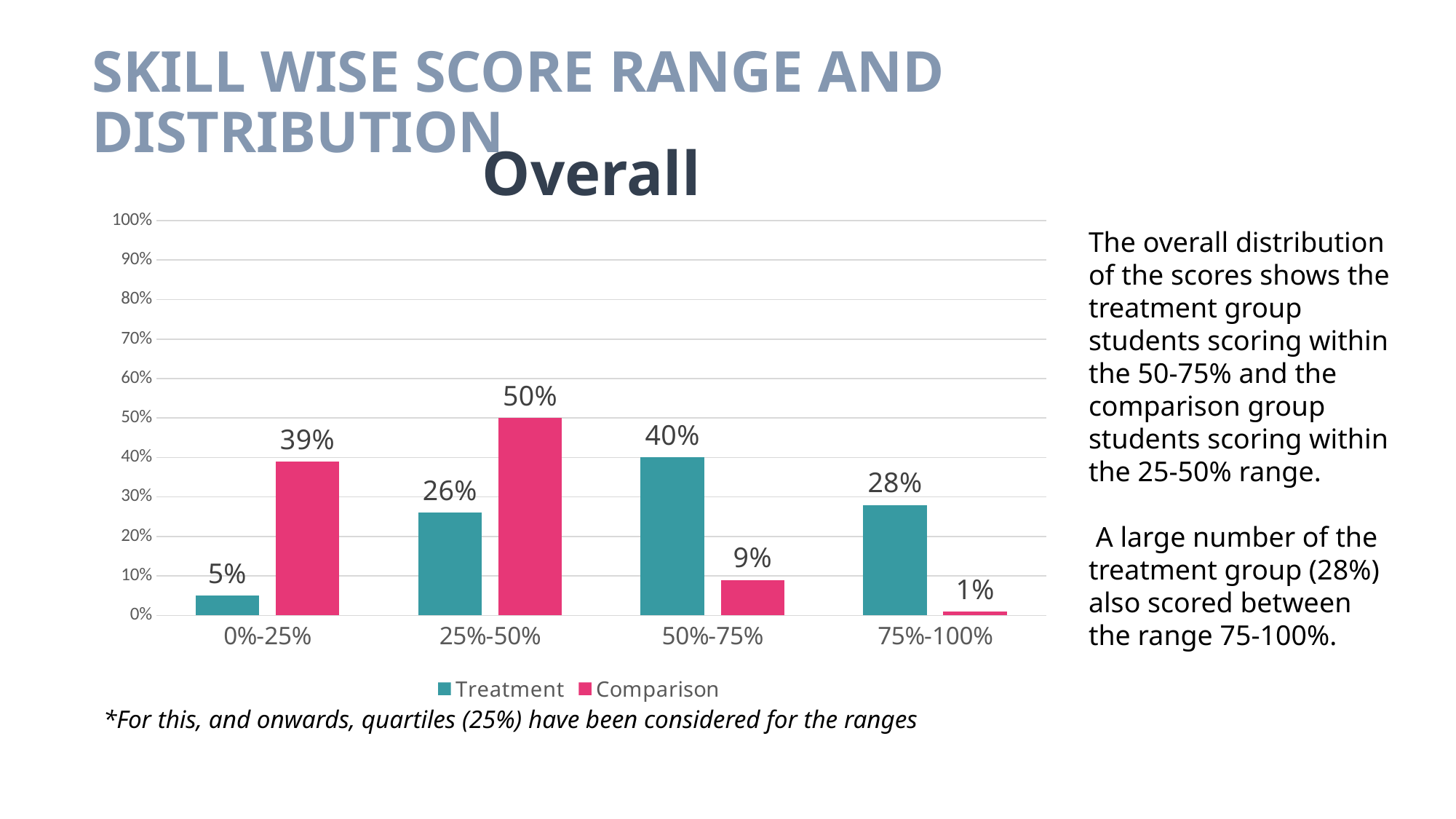
Which score range has the highest Treatment value? 50%-75% In the 25%-50% score range, which series has the larger value, Treatment or Comparison? Comparison What is the Comparison value for the 25%-50% score range? 50% What is the title of the chart? Overall Which score range has the lowest Comparison value? 75%-100% What is the difference between the Comparison and Treatment values in the 0%-25% score range? 34% How many series does the legend list? 2 What is the Treatment value for the 0%-25% score range? 5% What is the Treatment value for the 50%-75% score range? 40% What kind of chart is shown on the slide? Bar chart How many score ranges are shown on the x axis? 4 What is the Comparison value for the 75%-100% score range? 1%